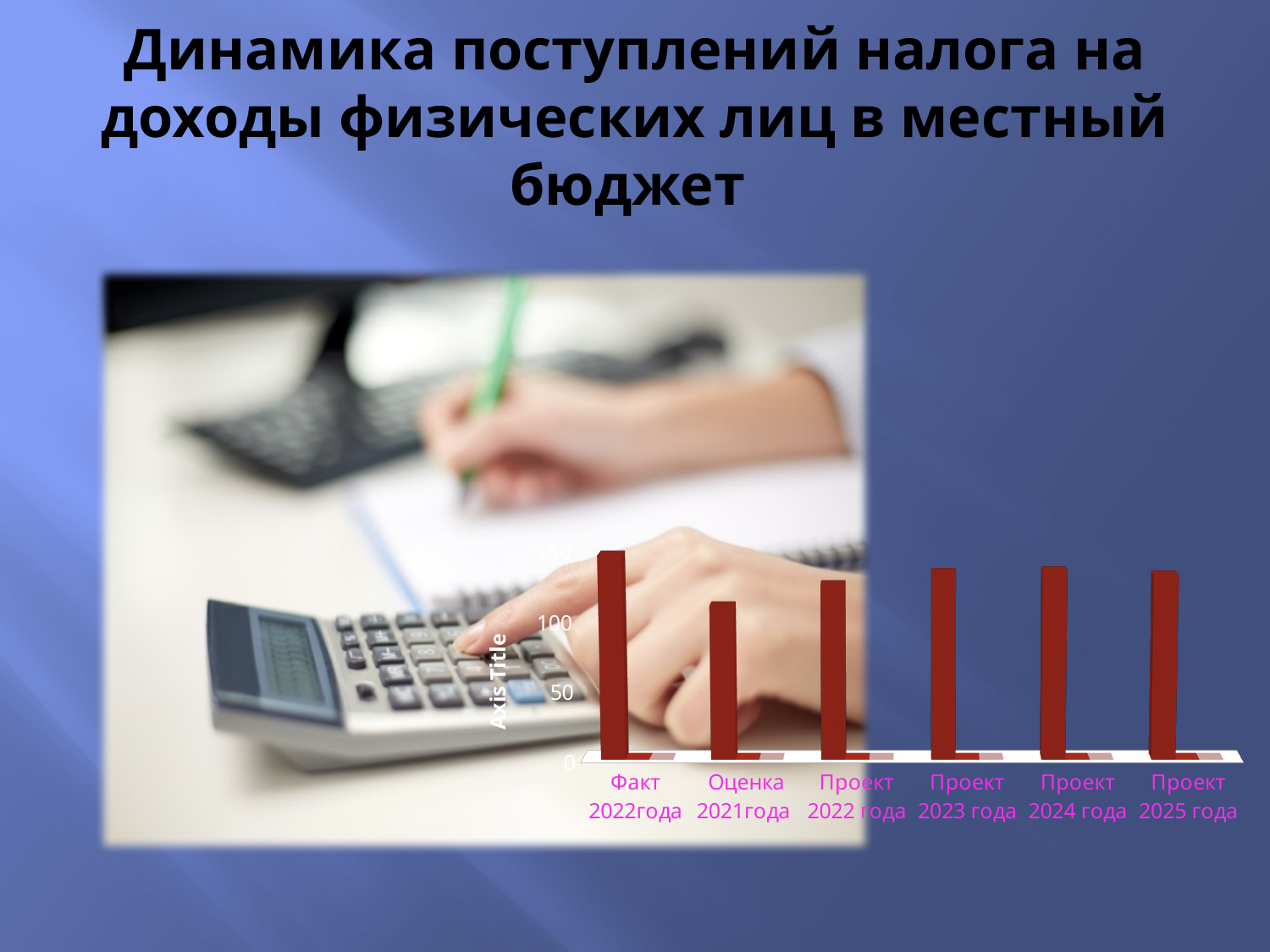
What text is shown as the vertical axis title of the chart? Axis Title What kind of chart is shown on the slide? bar chart Is the value for Оценка 2021года greater or less than 100? greater Is the value for Факт 2022года greater or less than 100? greater Is the value for Проект 2025 года greater or less than 150? less Which category has the highest bar in the chart? Факт 2022года Which is larger, the value for Факт 2022года or the value for Оценка 2021года? Факт 2022года Which is larger, the value for Проект 2022 года or the value for Оценка 2021года? Проект 2022 года How many categories are shown on the x axis of the chart? 6 Which category has the lowest bar in the chart? Оценка 2021года What is the highest tick value shown on the vertical axis of the chart? 150